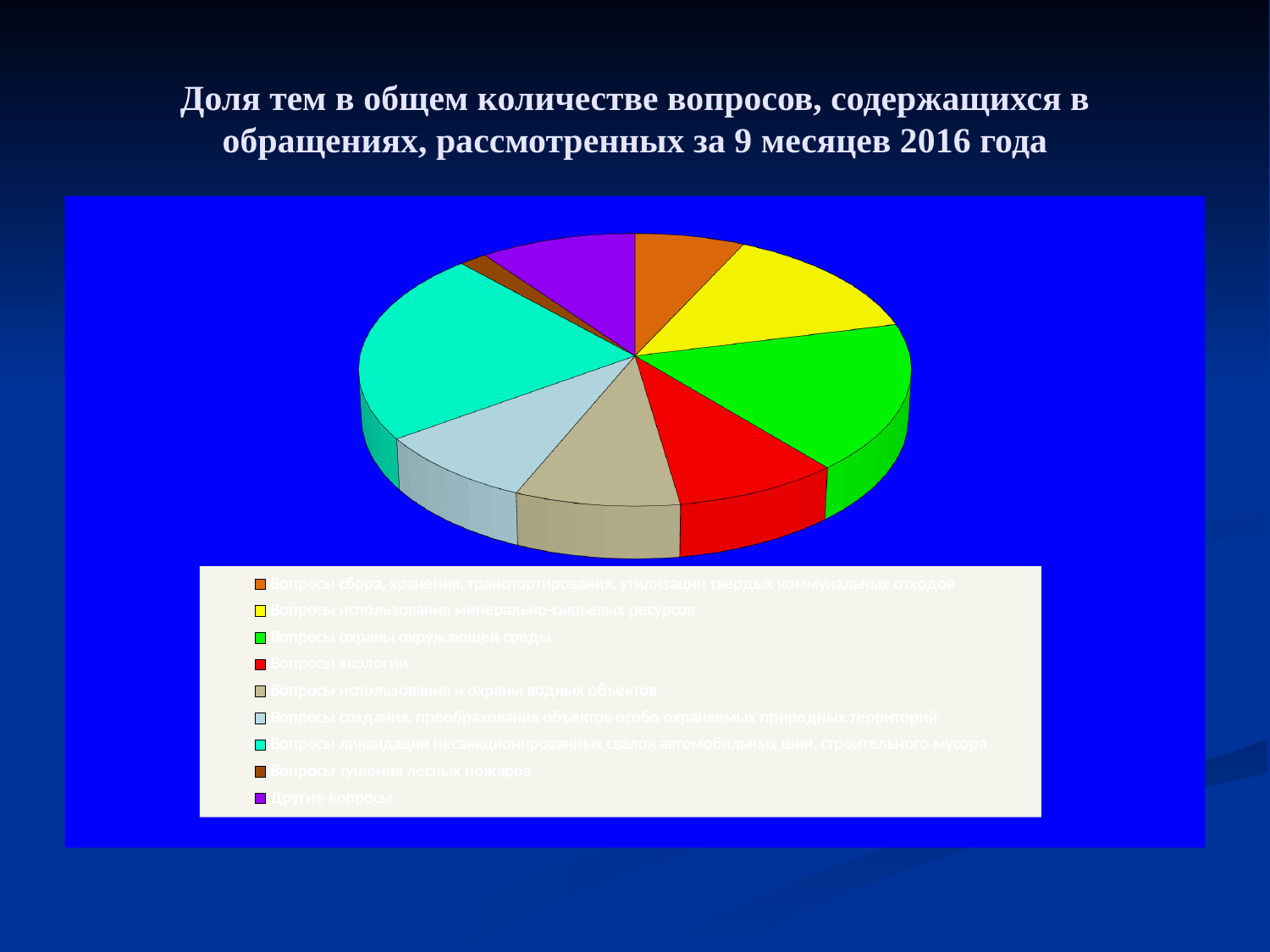
How many slices does the pie chart have? 9 What is the title of the chart on the slide? Доля тем в общем количестве вопросов, содержащихся в обращениях, рассмотренных за 9 месяцев 2016 года Which slice is larger: "Вопросы охраны окружающей среды" or "Вопросы сбора, хранения, транспортирования, утилизации твердых коммунальных отходов"? Вопросы охраны окружающей среды What colour is the slice for "Вопросы экологии"? Red Which slice is larger: "Вопросы охраны окружающей среды" or "Вопросы тушения лесных пожаров"? Вопросы охраны окружающей среды What kind of chart is shown on the slide? Pie chart Which topic has the largest slice of the pie? Вопросы ликвидации несанкционированных свалок автомобильных шин, строительного мусора Which slice is larger: "Вопросы ликвидации несанкционированных свалок автомобильных шин, строительного мусора" or "Другие вопросы"? Вопросы ликвидации несанкционированных свалок автомобильных шин, строительного мусора Which topic has the smallest slice of the pie? Вопросы тушения лесных пожаров